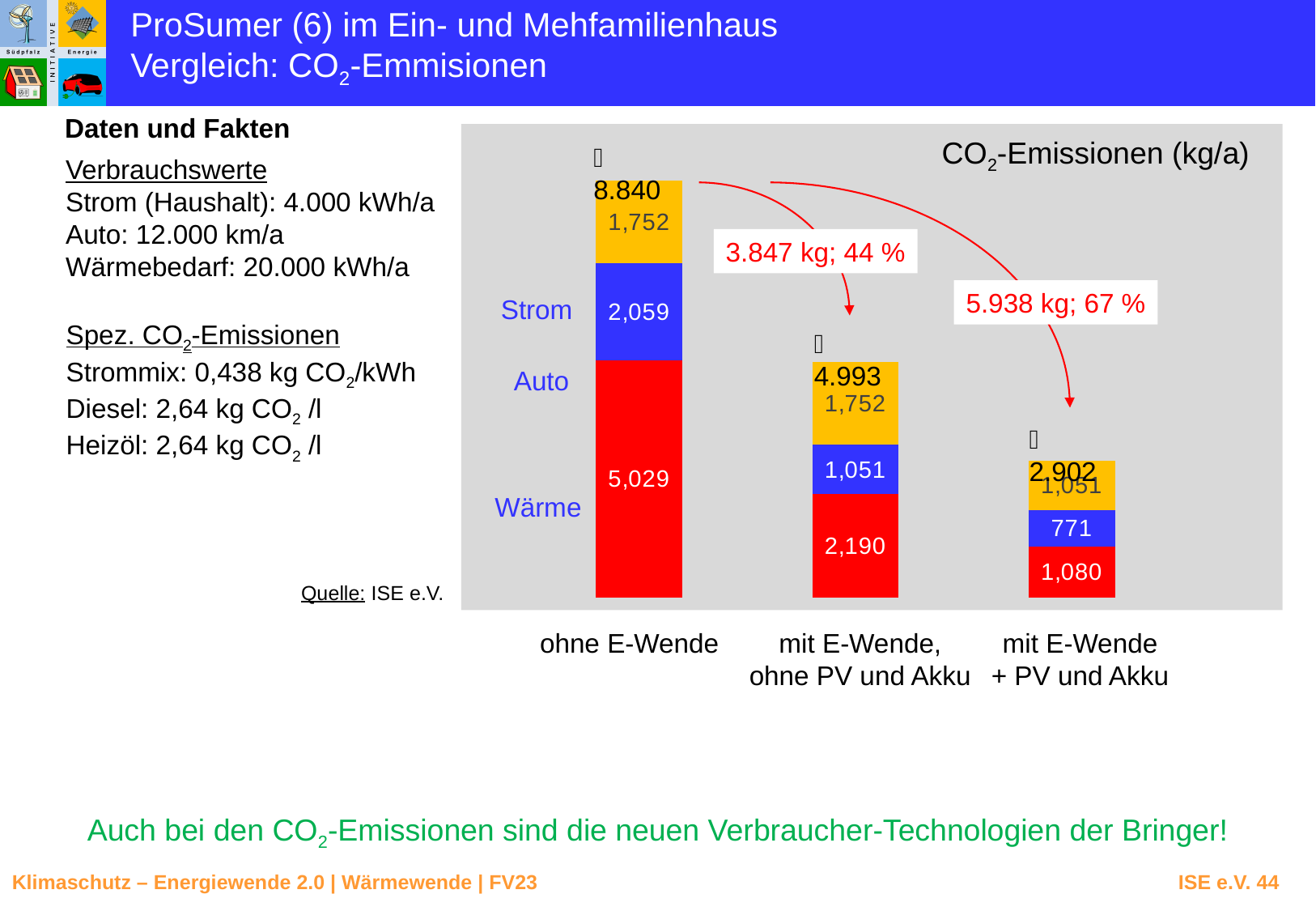
What is the total CO2 emission value printed above the bar for 'ohne E-Wende'? 8.840 What kind of chart is shown on the slide? Stacked bar chart What is the total CO2 emission value printed above the bar for 'mit E-Wende, ohne PV und Akku'? 4.993 What is the value of the blue middle segment in the 'mit E-Wende, ohne PV und Akku' bar? 1,051 How many scenarios (bars) are shown in the chart? 3 According to the annotation, by how much do emissions fall from 'ohne E-Wende' to 'mit E-Wende + PV und Akku'? 5.938 kg; 67 % Do the total CO2 emissions rise or fall from left to right across the three scenarios? Fall According to the annotation, by how much do emissions fall from 'ohne E-Wende' to 'mit E-Wende, ohne PV und Akku'? 3.847 kg; 44 % What is the total CO2 emission value printed above the bar for 'mit E-Wende + PV und Akku'? 2.902 Which scenario has the highest total CO2 emissions? ohne E-Wende What is the value of the red bottom segment in the 'ohne E-Wende' bar? 5,029 Which scenario has the lowest total CO2 emissions? mit E-Wende + PV und Akku